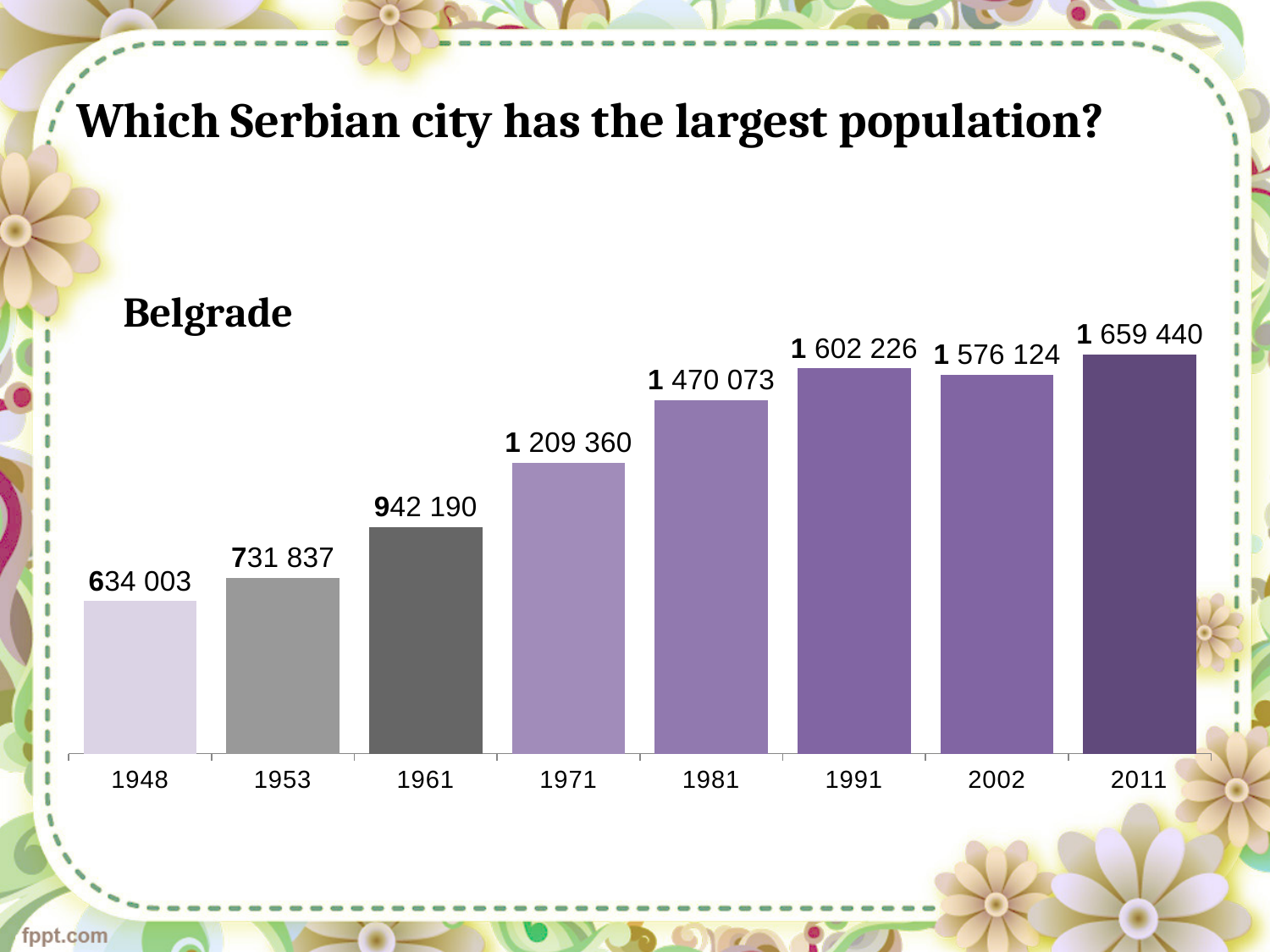
What kind of chart is shown on the slide? bar chart Which year has the highest population value on the chart? 2011 What is the difference between the population values for 1953 and 1948? 97 834 Which city's population does the chart show? Belgrade Do the population values generally rise or fall from 1948 to 2011? rise How many years are shown on the x axis of the chart? 8 What is the population of Belgrade shown for 1981? 1 470 073 Which year has the lowest population value on the chart? 1948 What is the difference between the population values for 1991 and 2002? 26 102 Which is larger, the population value for 1991 or for 2002? 1991 What is the population of Belgrade shown for 2002? 1 576 124 What is the population of Belgrade shown for 1948? 634 003